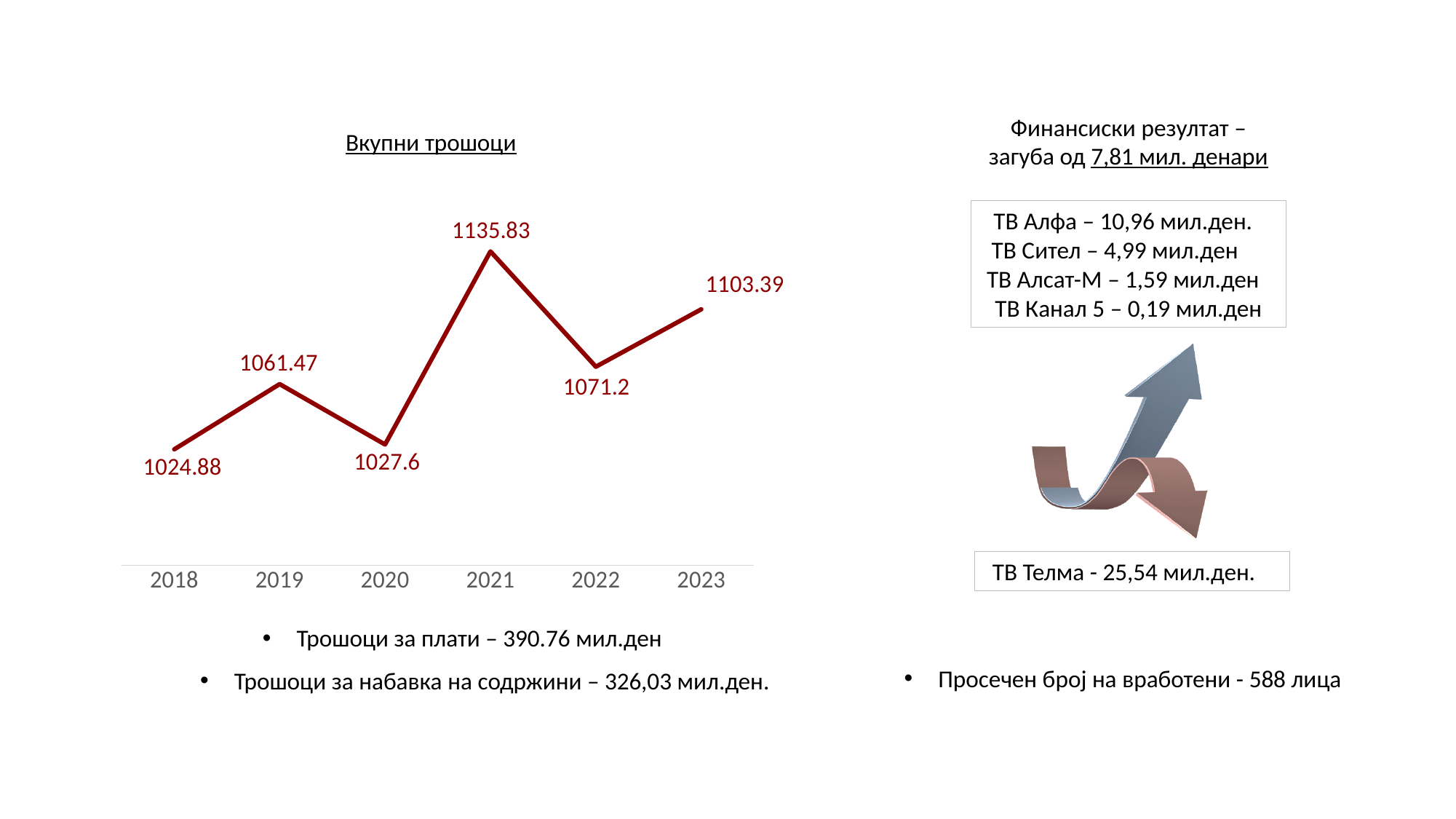
What is the difference between the values for 2021 and 2018? 110.95 What is the value for 2018 in the chart? 1024.88 Which is larger, the value for 2019 or the value for 2020? 2019 What type of chart is shown on the slide? Line chart What is the value for 2021 in the chart? 1135.83 Which year has the lowest value in the chart? 2018 Which year has the highest value in the chart? 2021 Does the value rise or fall from 2021 to 2022? Fall How many years are plotted in the chart? 6 What is the difference between the values for 2023 and 2022? 32.19 What is the title of the chart? Вкупни трошоци What is the value for 2023 in the chart? 1103.39